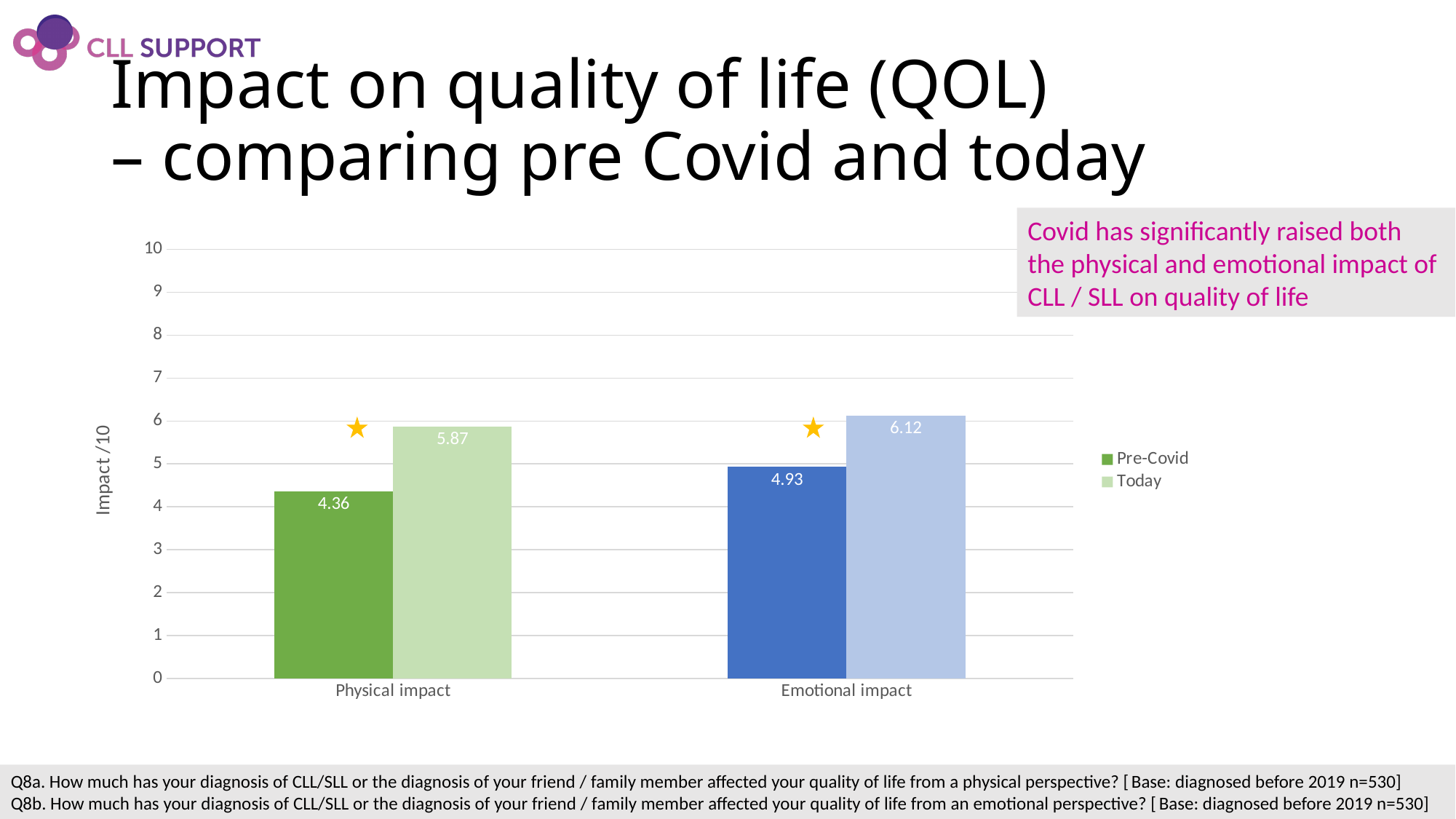
What is the Today value for Emotional impact? 6.12 What kind of chart is shown on the slide? Bar chart What is the Today value for Physical impact? 5.87 What is the Pre-Covid value for Physical impact? 4.36 What is the difference between the Today and Pre-Covid values for Emotional impact? 1.19 How many series does the legend list? 2 What is the difference between the Today and Pre-Covid values for Physical impact? 1.51 Which bar has the lowest value on the chart? Physical impact, Pre-Covid How many categories are shown on the x axis? 2 What is the Pre-Covid value for Emotional impact? 4.93 Which bar has the highest value on the chart? Emotional impact, Today Which is larger, the Pre-Covid value for Physical impact or the Pre-Covid value for Emotional impact? Emotional impact